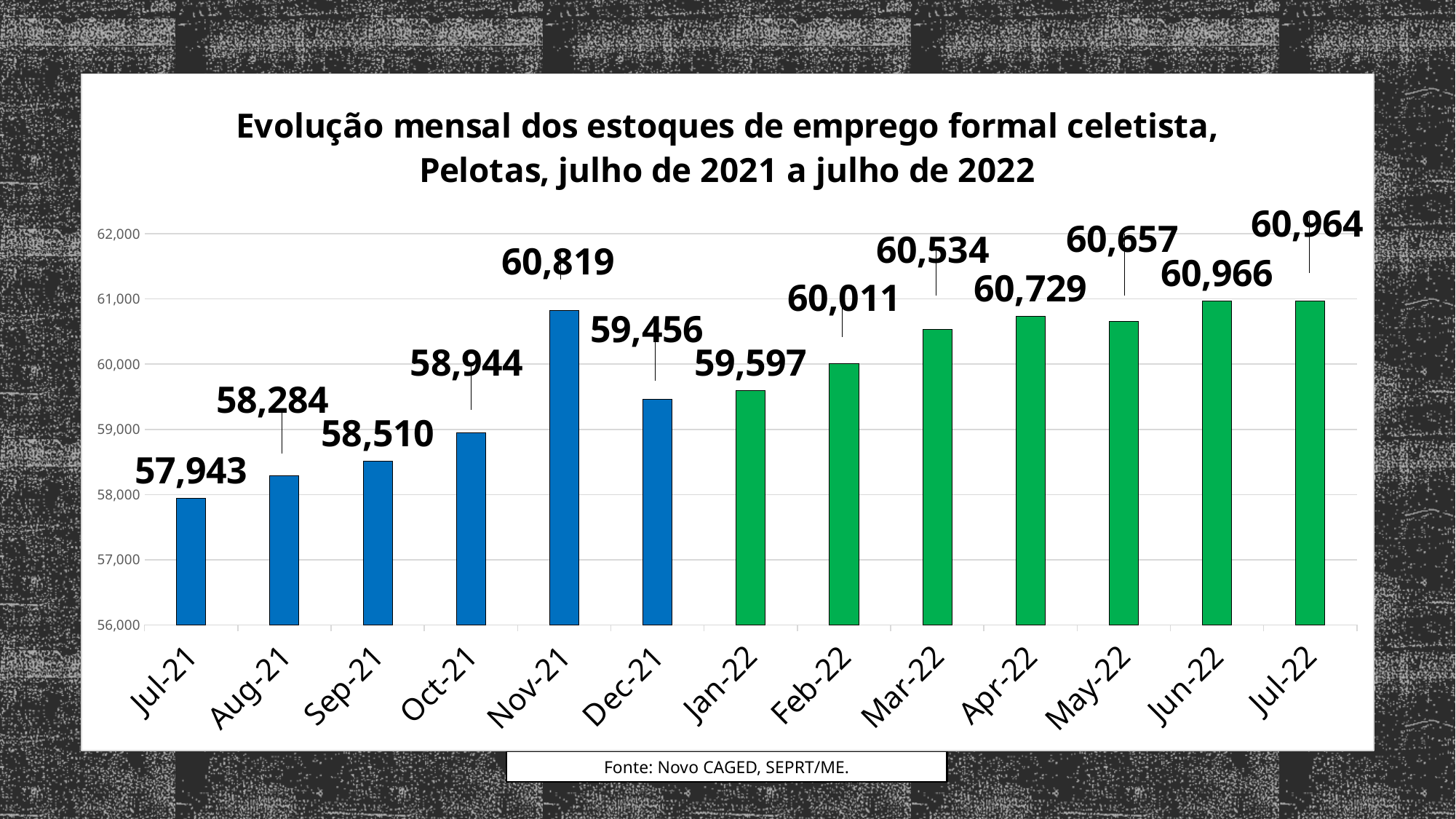
What is the difference between the values for Jul-22 and Jul-21? 3,021 What is the difference between the values for Nov-21 and Dec-21? 1,363 What is the value for Jul-21? 57,943 What is the value for Nov-21? 60,819 What kind of chart is shown on the slide? bar chart Which month has the lowest value? Jul-21 How many months are shown on the x axis? 13 What is the value for Apr-22? 60,729 What is the value for Feb-22? 60,011 Which is larger, the value for Nov-21 or the value for Jan-22? Nov-21 Is the value for Sep-21 greater or less than 59,000? less What source is cited below the chart? Novo CAGED, SEPRT/ME.